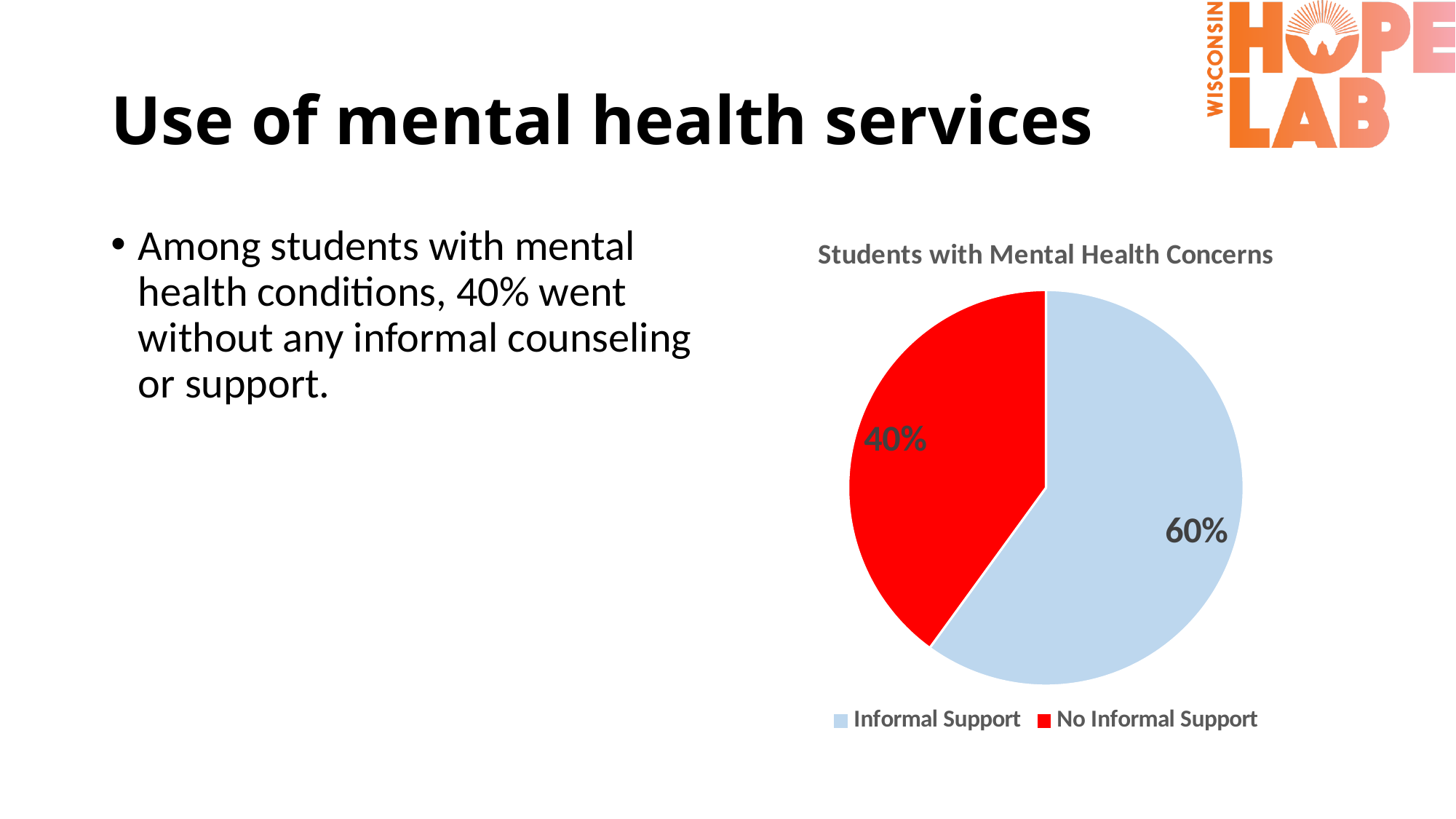
What kind of chart is shown on the slide? pie chart Which slice of the pie is the largest? Informal Support What is the title of the chart? Students with Mental Health Concerns How many slices does the pie chart have? 2 What share of the pie is labelled Informal Support? 60% Which slice of the pie is the smallest? No Informal Support What is the difference in percentage points between the Informal Support and No Informal Support slices? 20% Is the value for Informal Support greater or less than 50%? greater What share of the pie is labelled No Informal Support? 40% How many entries does the legend list? 2 Which is larger, the Informal Support slice or the No Informal Support slice? Informal Support What colour is the No Informal Support slice? red